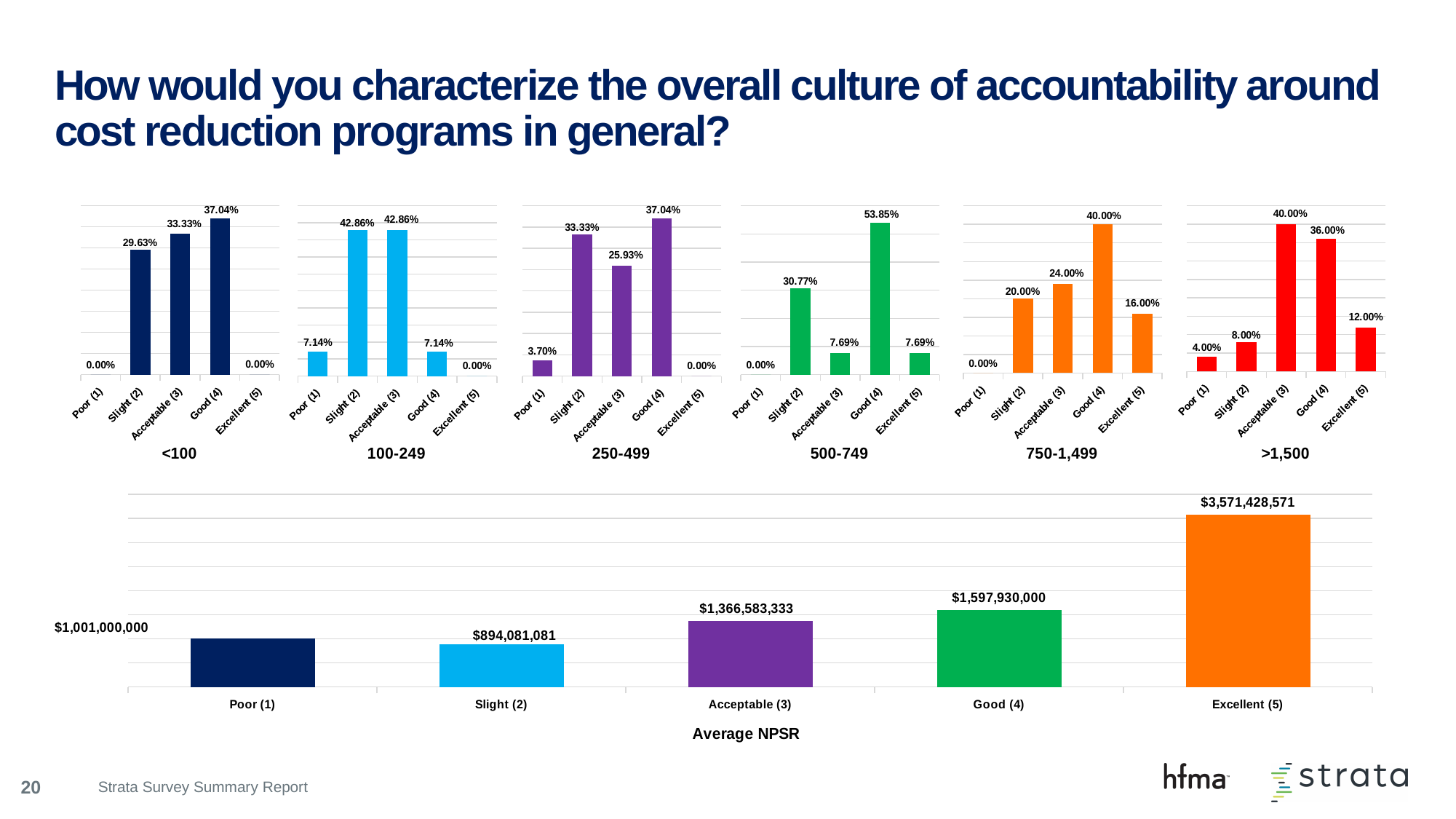
In the "500-749" chart, which category has the highest value? Good (4) In the "250-499" chart, what is the value for Acceptable (3)? 25.93% In the "Average NPSR" chart, which category has the lowest value? Slight (2) In the "750-1,499" chart, which is larger: Slight (2) or Excellent (5)? Slight (2) In the "Average NPSR" chart, what is the value for Excellent (5)? $3,571,428,571 In the "100-249" chart, what is the value for Poor (1)? 7.14% What kind of chart is the "Average NPSR" chart? bar chart In the "<100" chart, what is the value for Good (4)? 37.04% In the "Average NPSR" chart, what is the difference between Good (4) and Acceptable (3)? $231,346,667 In the ">1,500" chart, what is the difference between Acceptable (3) and Good (4)? 4.00% How many small bar charts are shown in the row above the "Average NPSR" chart? 6 In the "250-499" chart, how many categories are shown on the x axis? 5